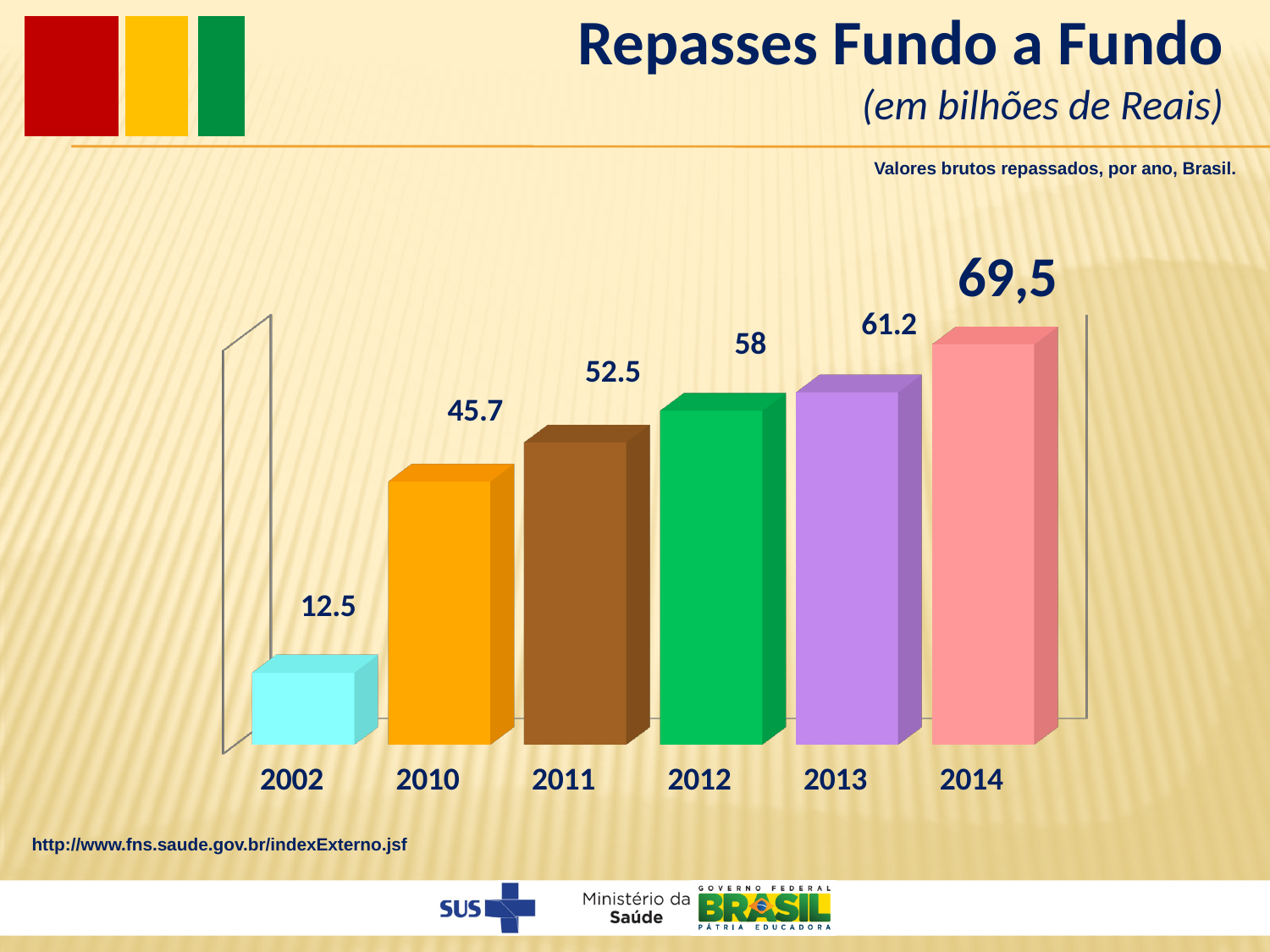
What is the difference between the values for 2013 and 2011? 8.7 How many years are shown on the chart? 6 What is the value for 2014? 69,5 What is the value for 2013? 61.2 What is the value for 2011? 52.5 Which year has the lowest value? 2002 Which year has the highest value? 2014 What is the difference between the values for 2012 and 2010? 12.3 Do the values rise or fall from 2002 to 2014? rise Which is larger, the value for 2010 or the value for 2012? 2012 What is the value for 2002? 12.5 What kind of chart is shown on the slide? bar chart